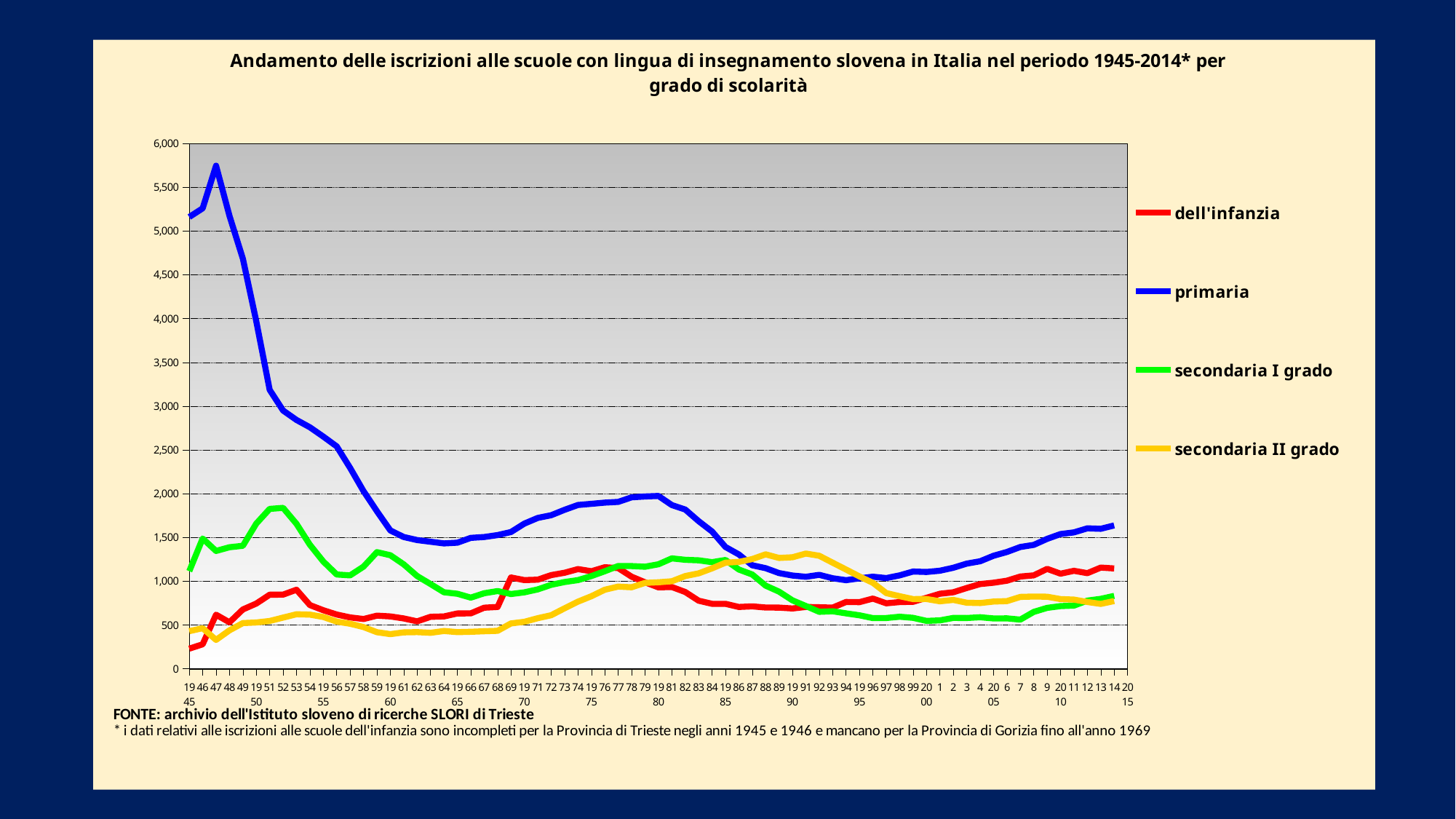
Is the value for primaria in 2014 greater or less than 1,500? greater What kind of chart is shown on the slide? line chart Is the value for secondaria I grado in 1952 greater or less than 1,500? greater Which series has the lowest value in 1960? secondaria II grado Which series is shown in blue? primaria Which series has the highest value in 1947? primaria How many series does the legend list? 4 Is the value for primaria in 1947 greater or less than 5,500? greater Does the primaria series rise or fall between 1947 and 1960? fall Which series has the lowest value in 2007? secondaria I grado